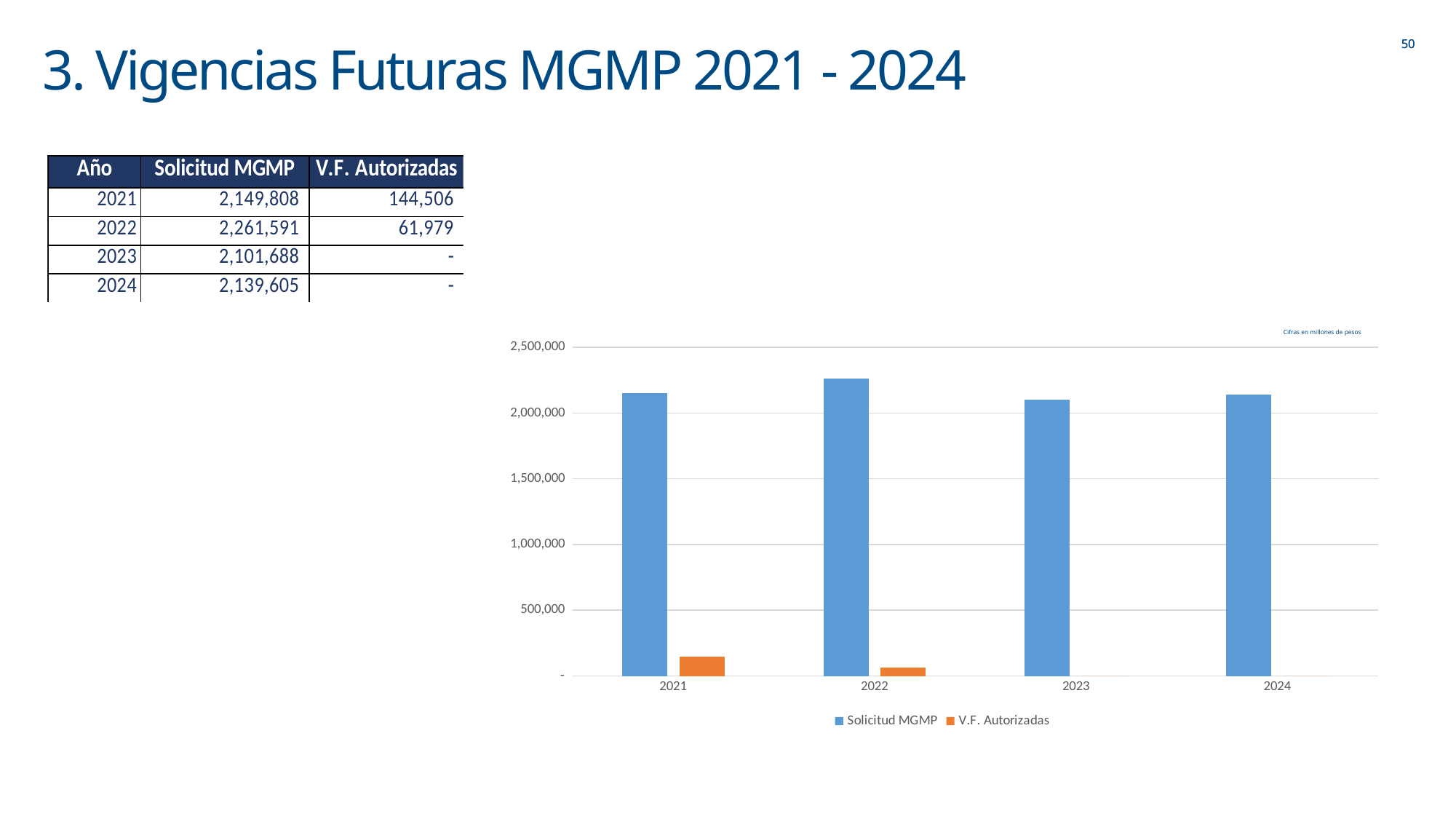
What colour are the V.F. Autorizadas bars in the chart? orange What is the difference between the Solicitud MGMP values for 2022 and 2021, using the figures printed on the slide? 111,783 Which year has the highest Solicitud MGMP bar? 2022 How many years are shown on the x axis of the chart? 4 Is the V.F. Autorizadas value for 2021 greater or less than 500,000? less What kind of chart is shown on the slide? bar chart What is the V.F. Autorizadas value for 2022, as printed on the slide? 61,979 Which is larger, the V.F. Autorizadas bar for 2021 or for 2022? 2021 Is the Solicitud MGMP value for 2022 greater or less than 2,000,000? greater How many series does the chart legend list? 2 What is the Solicitud MGMP value for 2021, as printed on the slide? 2,149,808 Which year has the lowest Solicitud MGMP bar? 2023